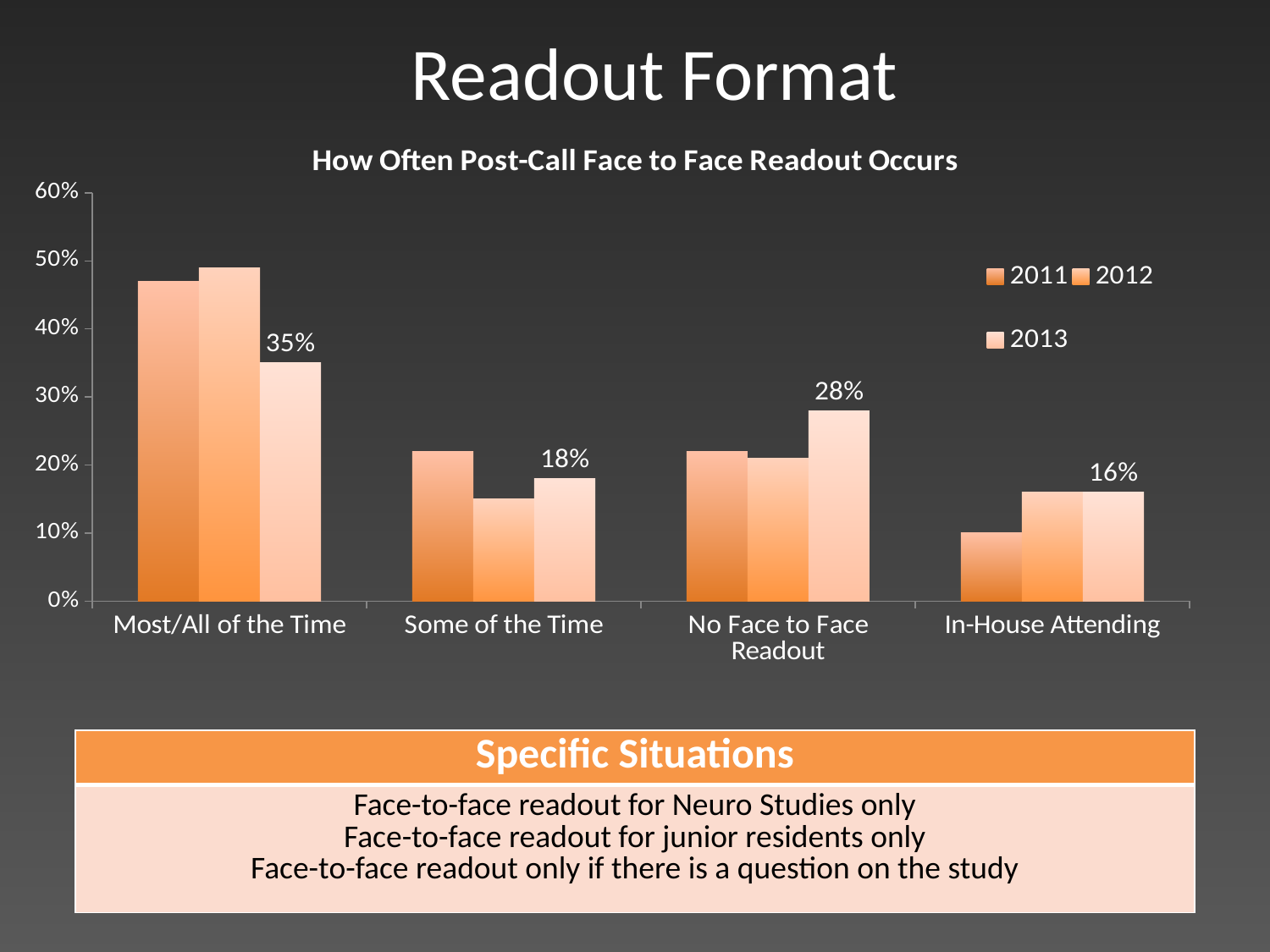
What is the 2013 value for No Face to Face Readout? 28% What is the 2013 value for Some of the Time? 18% What is the 2013 value for Most/All of the Time? 35% Is the 2011 value for Most/All of the Time greater or less than 40%? greater How many series does the legend list? 3 Which category has the lowest 2013 value? In-House Attending Is the 2011 value for In-House Attending greater or less than 20%? less What is the 2013 value for In-House Attending? 16% Which category has the highest 2013 value? Most/All of the Time How many categories are shown on the x axis? 4 What is the difference between the 2013 values for Most/All of the Time and In-House Attending? 19 percentage points For 2013, which is larger: No Face to Face Readout or Some of the Time? No Face to Face Readout